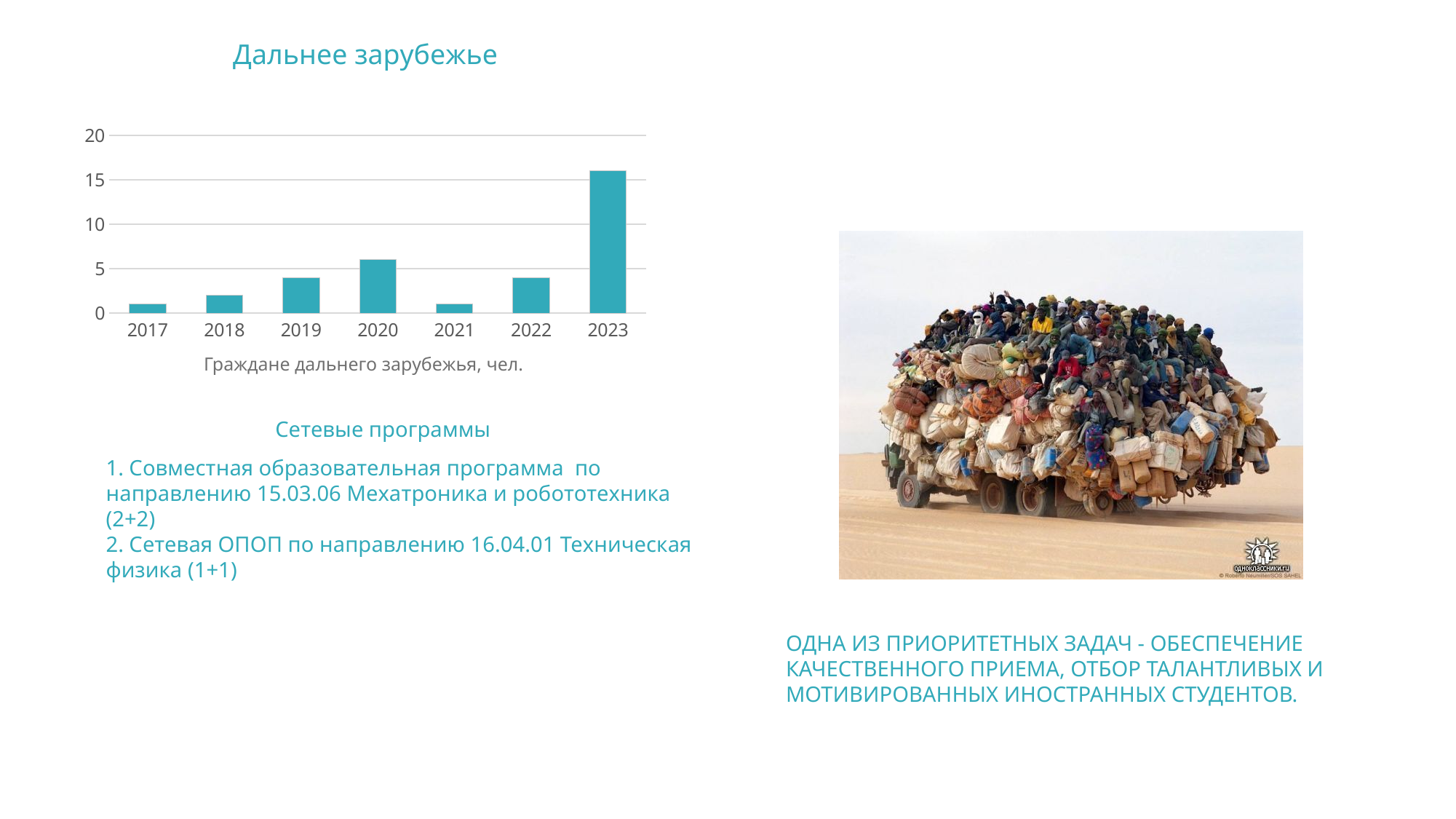
Is the value for 2019 greater or less than 5? less Is the value for 2023 greater or less than 15? greater What is the legend entry shown below the chart? Граждане дальнего зарубежья, чел. What kind of chart is shown on the slide? bar chart Which is larger, the value for 2023 or the value for 2020? 2023 How many years are shown on the x axis of the chart? 7 Which is larger, the value for 2020 or the value for 2019? 2020 Does the value rise or fall from 2022 to 2023? rise Is the value for 2021 greater or less than 5? less Which year has the highest value in the chart? 2023